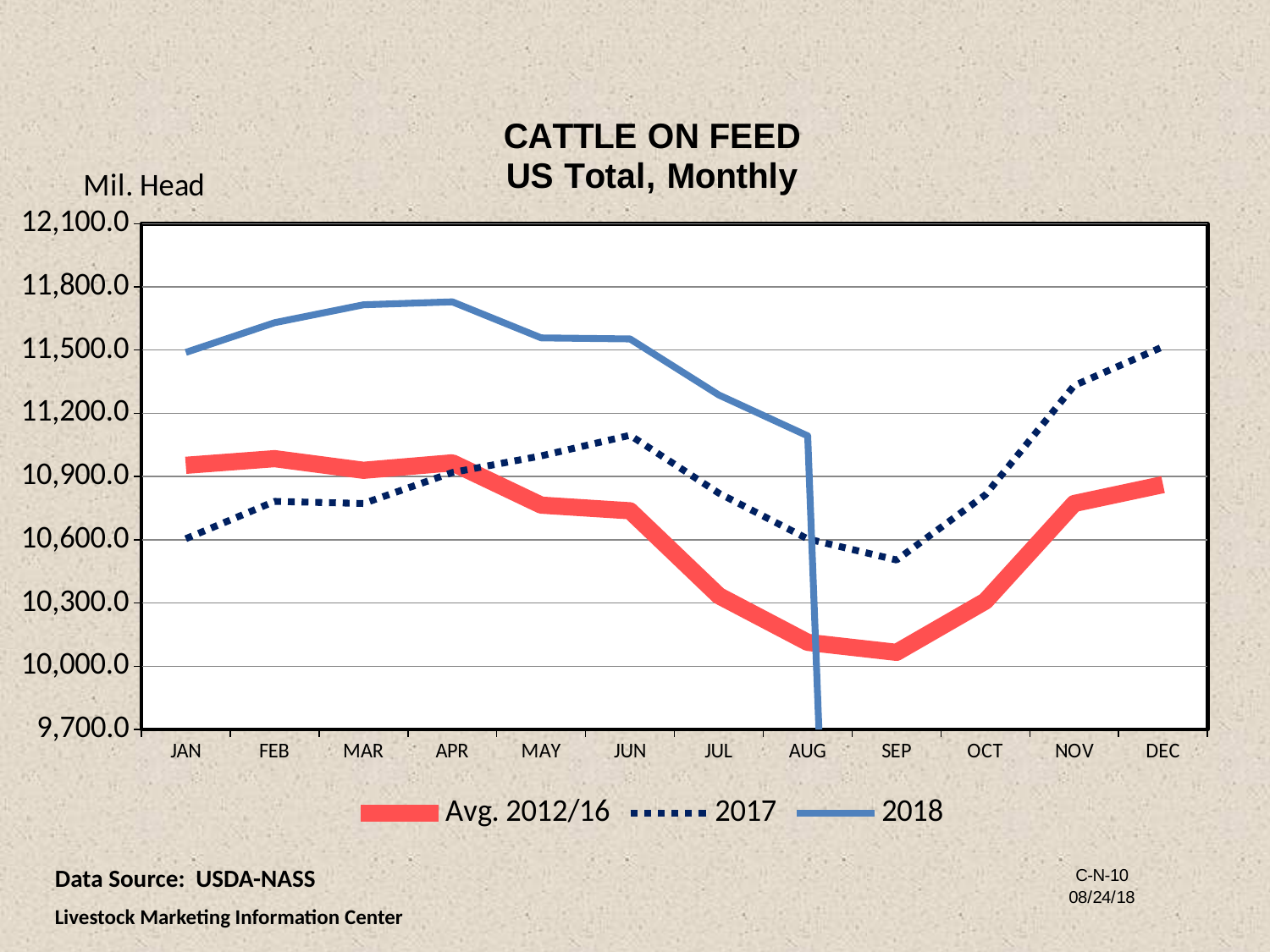
How many months are shown along the x axis? 12 In JAN, which series has the larger value, 2018 or Avg. 2012/16? 2018 In which month is the 2017 series at its lowest? SEP Is the value for 2018 in APR greater or less than 11,500.0? greater Does the 2018 series rise or fall from APR to AUG? fall What kind of chart is shown on the slide? line chart Is the value for 2018 in JAN greater or less than 11,200.0? greater In which month is the 2017 series at its highest? DEC Is the value for 2017 in JAN greater or less than 10,900.0? less How many series does the legend list? 3 What is the label on the y axis? Mil. Head